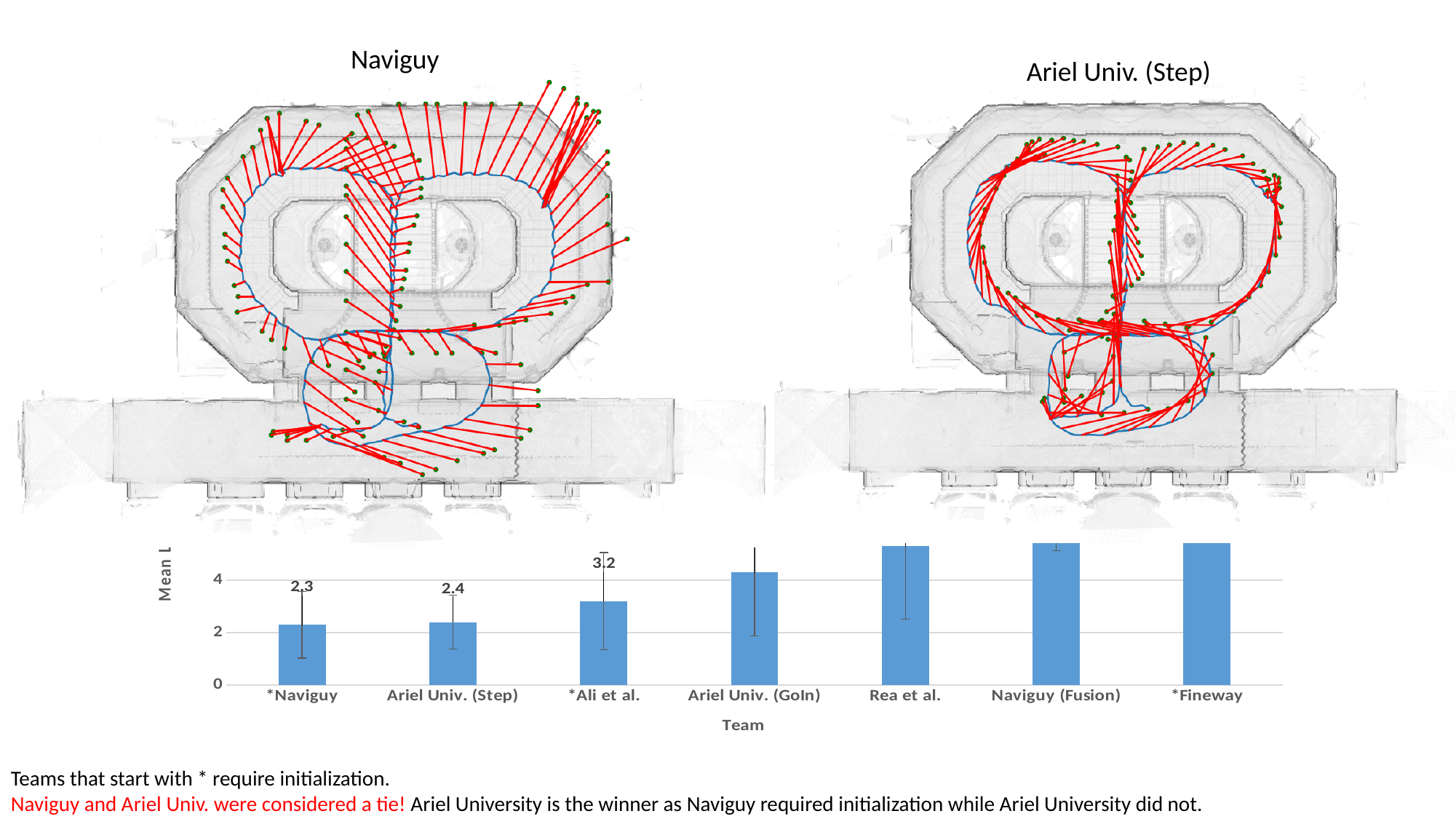
In the bar chart, is the value for Rea et al. greater or less than 4? greater In the bar chart, which is larger: the value for *Ali et al. or for Ariel Univ. (Step)? *Ali et al. In the bar chart, what is the difference between the values for *Ali et al. and *Naviguy? 0.9 What kind of chart is shown at the bottom of the slide? Bar chart How many teams are shown in the bar chart? 7 In the bar chart, what is the difference between the values for Ariel Univ. (Step) and *Naviguy? 0.1 In the bar chart, what is the value for *Naviguy? 2.3 In the bar chart, do the values rise or fall from left to right along the x axis? Rise In the bar chart, what is the value for Ariel Univ. (Step)? 2.4 In the bar chart, which team has the lowest value? *Naviguy In the bar chart, is the value for Naviguy (Fusion) greater or less than 4? greater In the bar chart, what is the value for *Ali et al.? 3.2